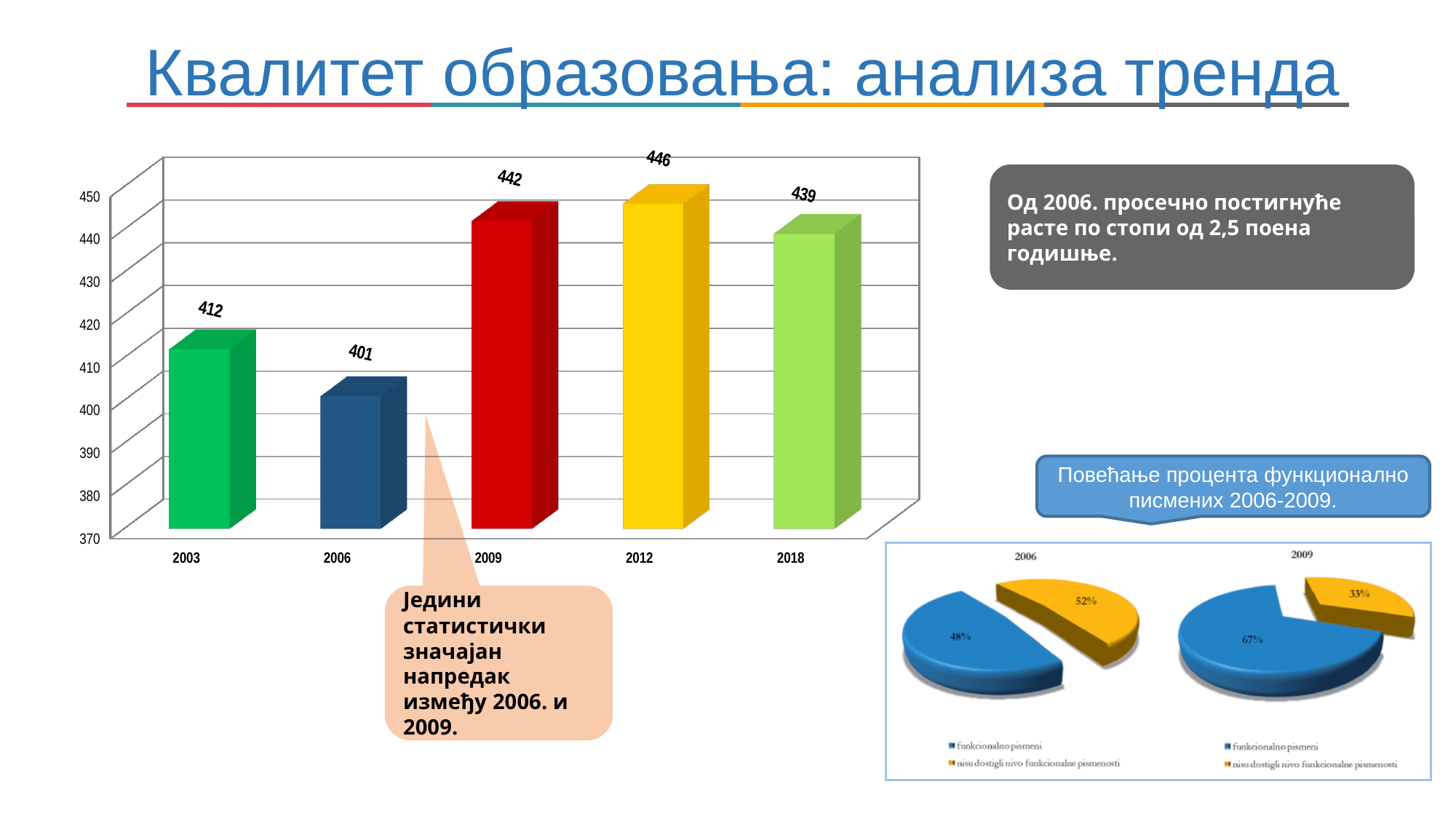
How many entries does the legend list under each pie chart at the bottom right? 2 In the bar chart on the left, which year has the highest value? 2012 In the bar chart on the left, what is the value for 2009? 442 In the bar chart on the left, which year has the lowest value? 2006 In the bar chart on the left, what is the value for 2006? 401 In the bar chart on the left, do the values rise or fall from 2006 to 2012? rise What kind of chart is the chart on the left of the slide? bar chart How many bars are shown in the bar chart on the left? 5 In the bar chart on the left, what is the difference between the values for 2009 and 2006? 41 In the pie chart labelled 2006 at the bottom right, what share is labelled on the blue slice (funkcionalno pismeni)? 48% In the pie chart labelled 2009 at the bottom right, what share is labelled on the yellow slice (nisu dostigli nivo funkcionalne pismenosti)? 33% In the bar chart on the left, which is larger, the value for 2003 or the value for 2018? 2018